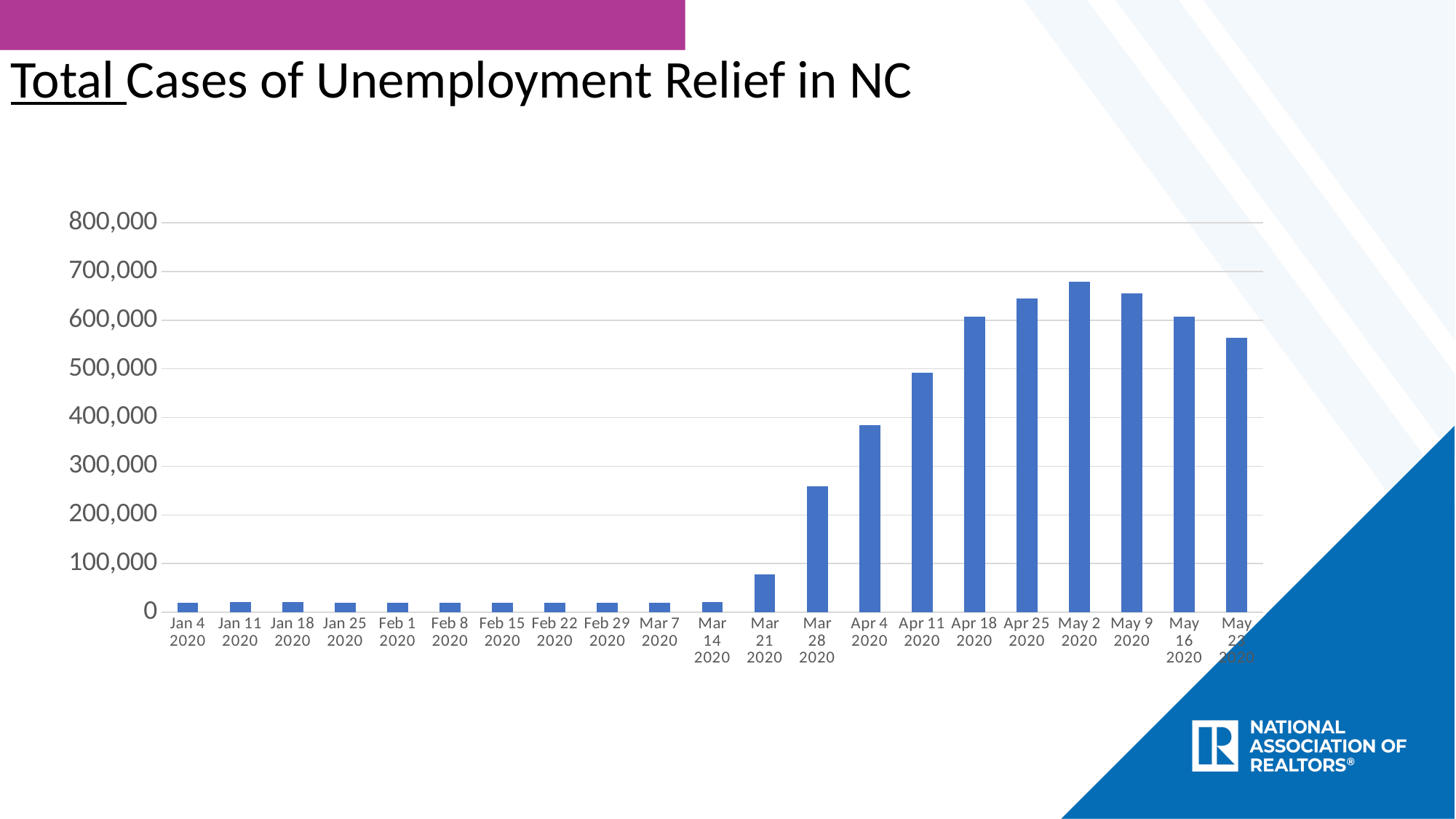
Is the value for May 23 2020 greater or less than 600,000? less Is the value for Mar 28 2020 greater or less than 200,000? greater Which is larger, the value for Apr 25 2020 or May 16 2020? Apr 25 2020 Is the value for Mar 21 2020 greater or less than 100,000? less Which is larger, the value for Mar 28 2020 or Apr 4 2020? Apr 4 2020 What kind of chart is shown on the slide? Bar chart What is the title of the chart? Total Cases of Unemployment Relief in NC How many dates (bars) are shown on the x axis? 21 Which date has the highest number of cases? May 2 2020 Do the values rise or fall from May 2 2020 to May 23 2020? Fall